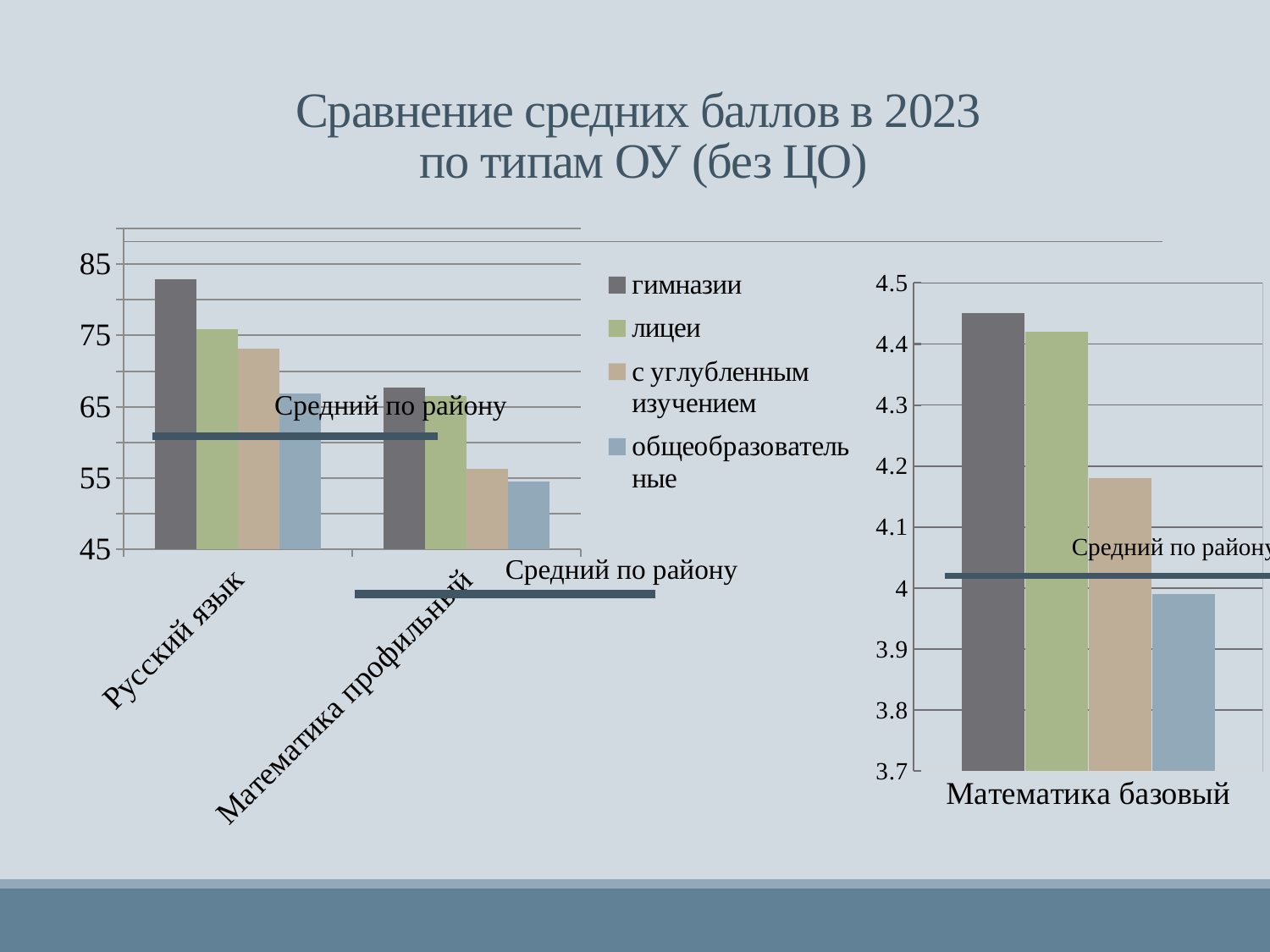
What is the category label on the x axis of the right chart? Математика базовый In the left chart, do the values for гимназии rise or fall from Русский язык to Математика профильный? fall In the right chart, is the value for с углубленным изучением greater or less than 4.3? less In the right chart, which series has the lowest value? общеобразовательные How many series does the legend of the left chart list? 4 What is the label of the horizontal line drawn across the bars in the right chart? Средний по району In the left chart, which series has the highest value for Русский язык? гимназии How many categories are shown on the x axis of the left chart? 2 In the left chart, is the value of с углубленным изучением for Математика профильный greater or less than 65? less What kind of chart is the left chart on the slide? bar chart In the left chart, is the value of гимназии for Русский язык greater or less than 75? greater In the left chart, for Русский язык, which is larger: лицеи or с углубленным изучением? лицеи